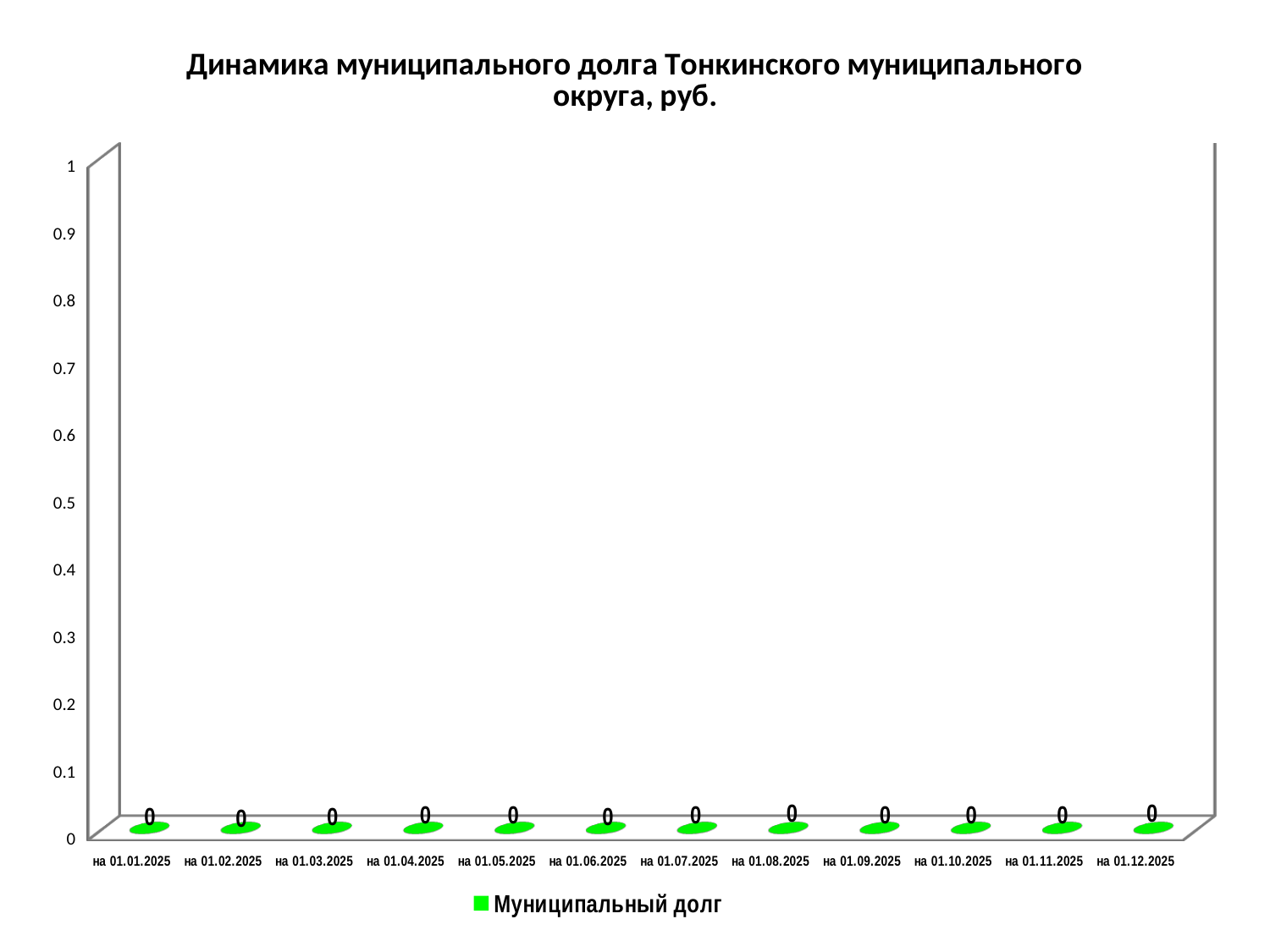
What is the value for на 01.12.2025? 0 What is the name of the series shown in the legend? Муниципальный долг Is the value for на 01.07.2025 greater or less than 0.5? less What is the value for на 01.06.2025? 0 What is the value for на 01.01.2025? 0 What is the difference between the values for на 01.03.2025 and на 01.10.2025? 0 What is the title of the chart? Динамика муниципального долга Тонкинского муниципального округа, руб. Do the values rise, fall, or stay flat from на 01.01.2025 to на 01.12.2025? Stay flat How many series does the legend list? 1 What is the value for на 01.09.2025? 0 What kind of chart is this? Bar chart How many categories (dates) are shown on the x axis? 12